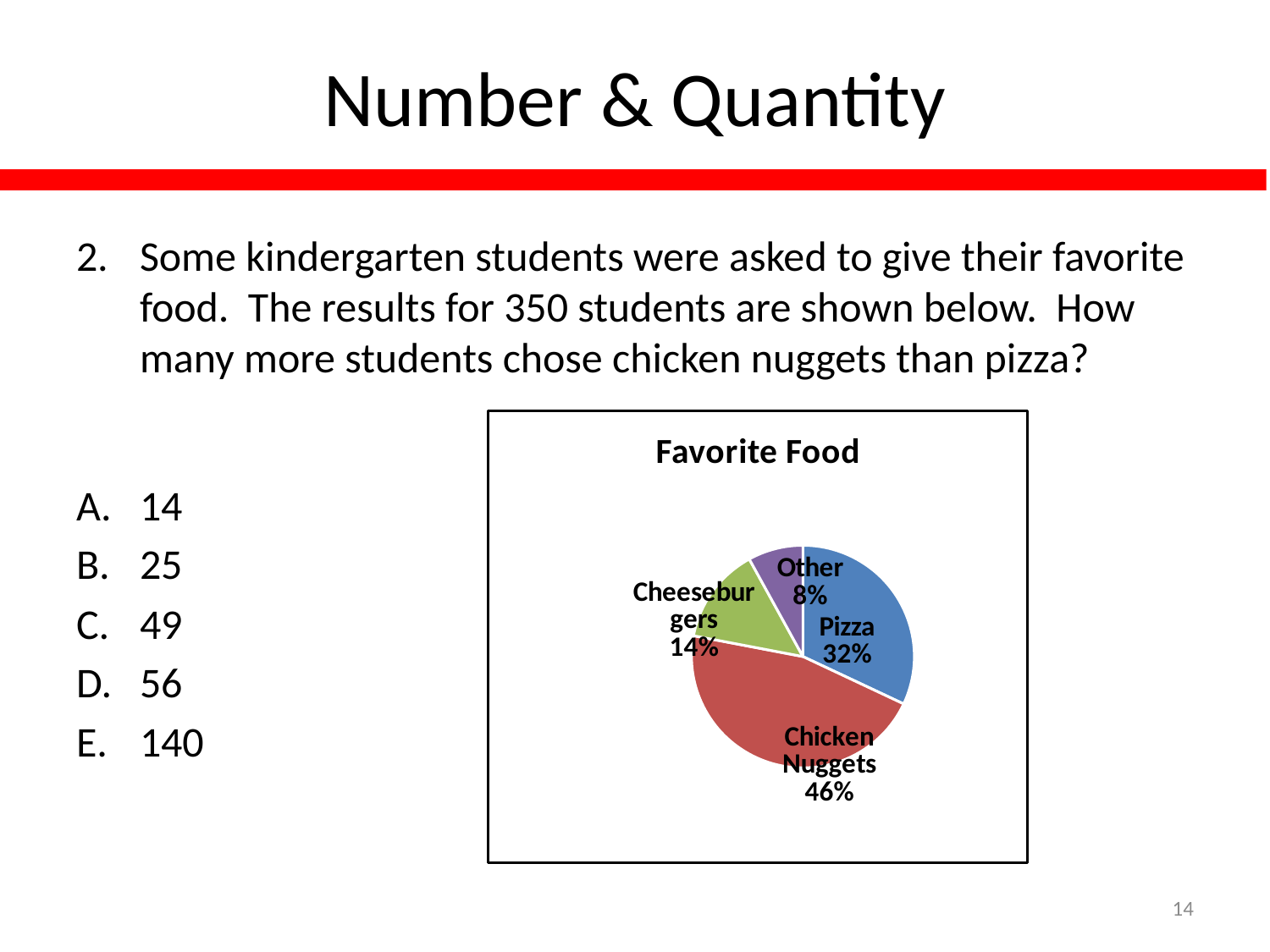
What percentage of students chose Pizza? 32% What colour is the Chicken Nuggets slice? red How many slices does the pie chart have? 4 Which has a larger share, Cheeseburgers or Other? Cheeseburgers What percentage of students chose Cheeseburgers? 14% What type of chart is shown on the slide? pie chart What percentage of students chose Chicken Nuggets? 46% What is the title of the chart? Favorite Food What is the difference in percentage points between Chicken Nuggets and Pizza? 14 Which category has the smallest share of the pie? Other Which food has the largest share of the pie? Chicken Nuggets What percentage is labelled for the Other slice? 8%